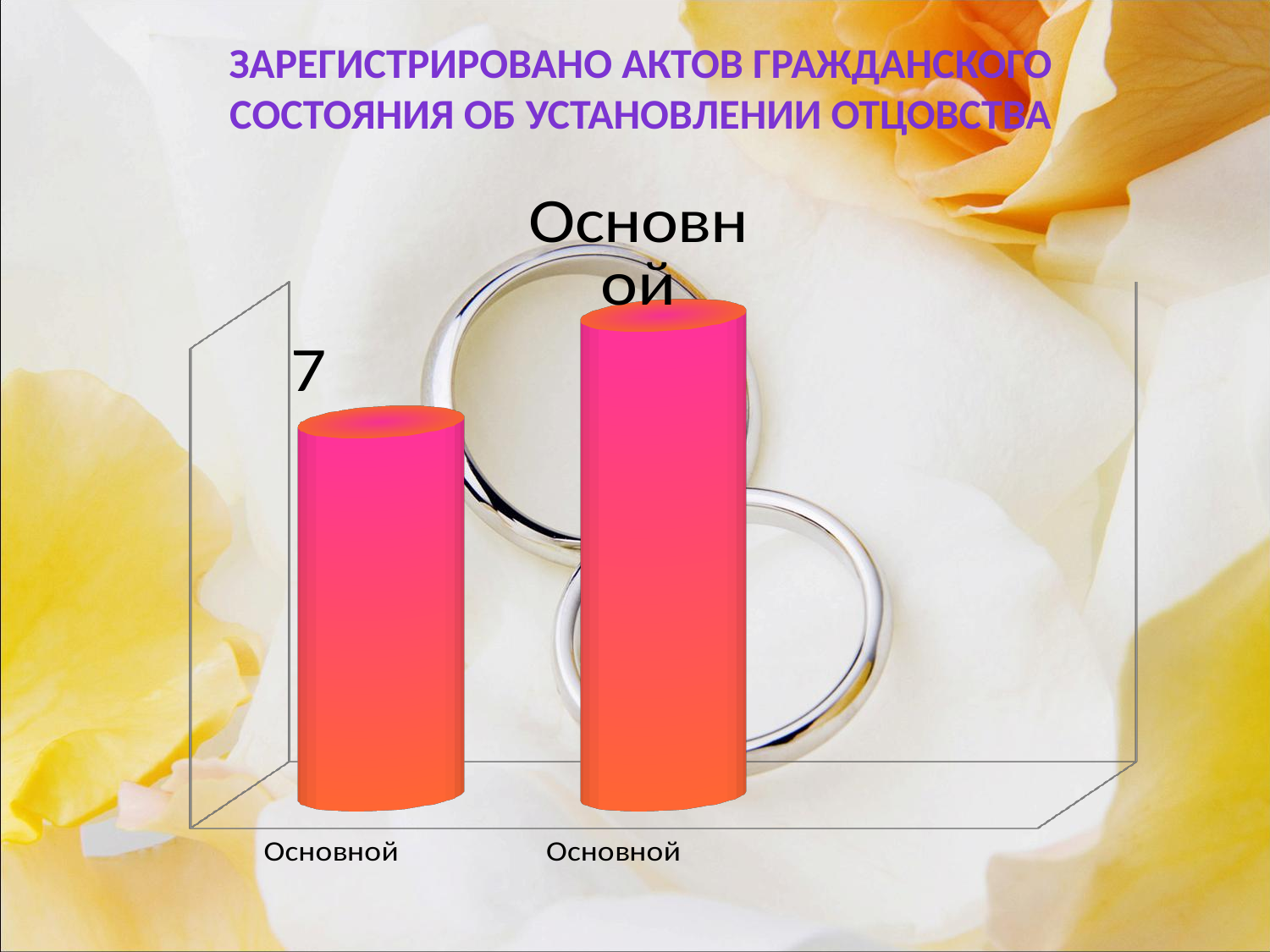
What value is printed on the left bar of the chart? 7 Which bar in the chart is the highest? the right bar How many bars does the chart contain? 2 Do the bar values rise or fall from left to right? rise Which bar in the chart is the lowest? the left bar What label is shown under each bar on the category axis? Основной What kind of chart is shown on the slide? bar chart Which bar is taller, the left one or the right one? the right one What is the title of the slide above the chart? ЗАРЕГИСТРИРОВАНО АКТОВ ГРАЖДАНСКОГО СОСТОЯНИЯ ОБ УСТАНОВЛЕНИИ ОТЦОВСТВА